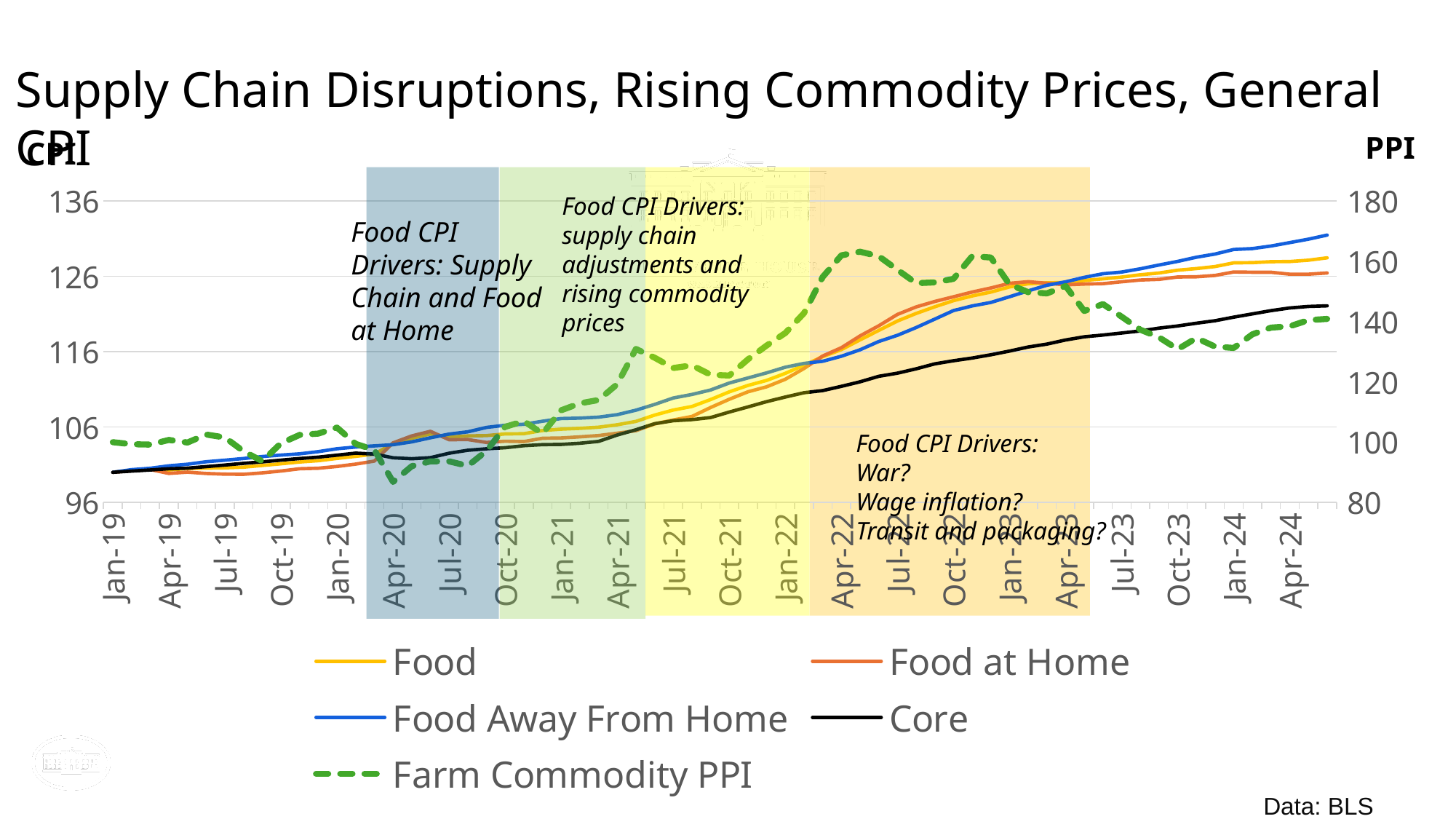
Is the value for Farm Commodity PPI at Apr-20 greater or less than 100 on the PPI axis? less Is the value for Core at Apr-24 greater or less than 116? greater What is the label of the right-hand vertical axis? PPI Among the CPI series, which has the lowest value at Apr-24? Core Is the peak value of Farm Commodity PPI around Apr-22 greater or less than 140 on the PPI axis? greater How many series does the legend list? 5 At Apr-24, which is higher: Food Away From Home or Core? Food Away From Home Among the CPI series, which has the highest value at Apr-24? Food Away From Home What kind of chart is shown on the slide? line chart Does the Core series rise or fall from Jan-19 to Apr-24? rise Which series is drawn with a dashed line? Farm Commodity PPI